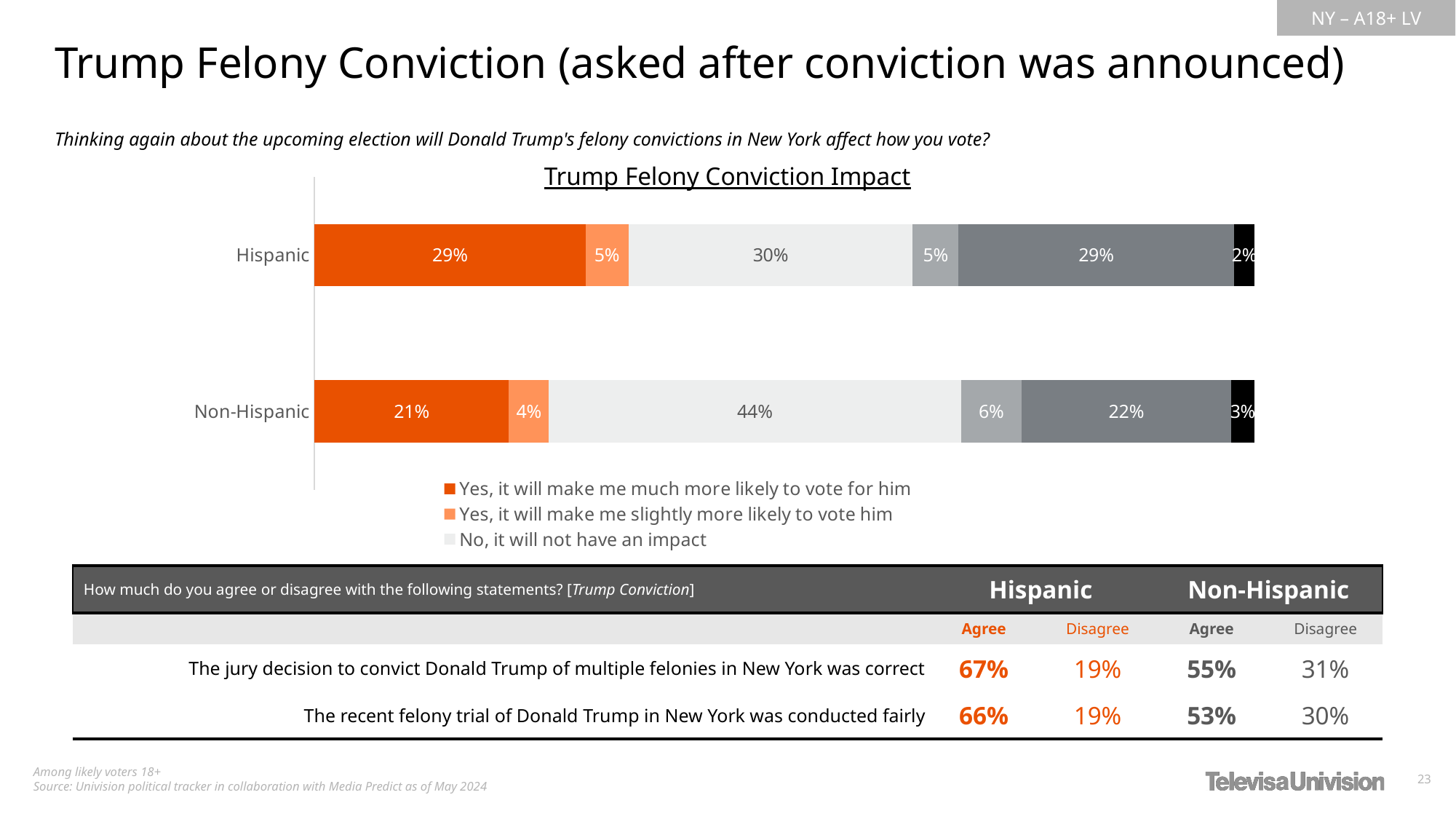
In the Trump Felony Conviction Impact chart, which of the legend responses has the largest share among Non-Hispanic respondents? No, it will not have an impact In the Trump Felony Conviction Impact chart, what percentage of Hispanic respondents said it will not have an impact? 30% How many respondent groups are shown in the Trump Felony Conviction Impact chart? 2 In the Trump Felony Conviction Impact chart, what do the segments of the Hispanic bar add up to? 100% In the Trump Felony Conviction Impact chart, what percentage of Non-Hispanic respondents said it will not have an impact? 44% In the Trump Felony Conviction Impact chart, which group has the larger share saying it will not have an impact, Hispanic or Non-Hispanic? Non-Hispanic How many entries does the legend of the Trump Felony Conviction Impact chart list? 3 In the Trump Felony Conviction Impact chart, what percentage of Non-Hispanic respondents said it will make them slightly more likely to vote for him? 4% What type of chart is the Trump Felony Conviction Impact chart? Stacked bar chart In the Trump Felony Conviction Impact chart, what percentage of Hispanic respondents said it will make them much more likely to vote for him? 29% In the Trump Felony Conviction Impact chart, how many percentage points higher is the 'much more likely to vote for him' share for Hispanic respondents than for Non-Hispanic respondents? 8 percentage points In the Trump Felony Conviction Impact chart, what is the difference between the Non-Hispanic and Hispanic shares saying it will not have an impact? 14 percentage points